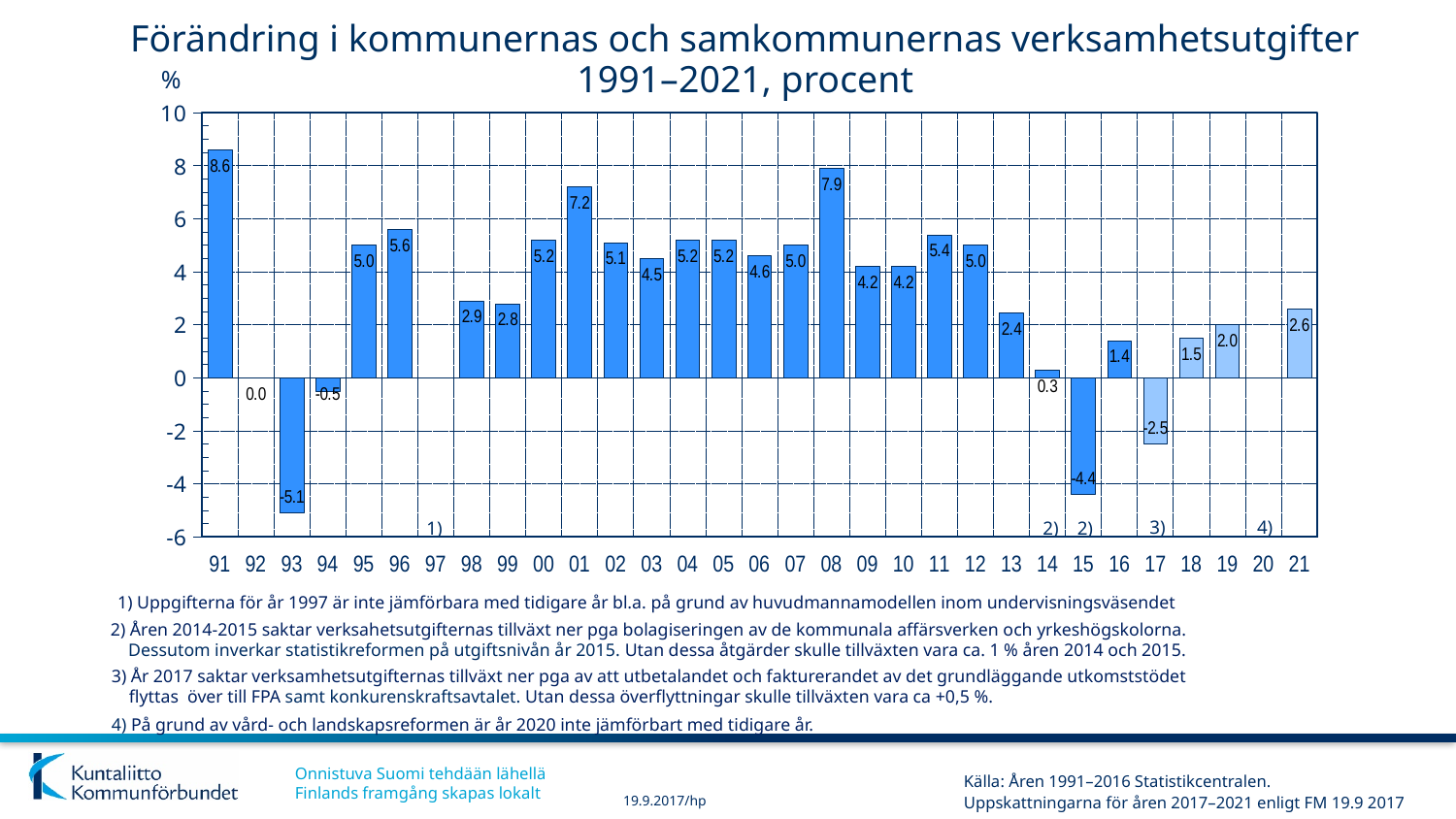
Which year has the lowest value? 1993 (93) Do the values rise or fall from 2018 to 2019? Rise What is the value for 1993? -5.1 Which is larger, the value for 2011 or the value for 2013? 2011 What is the value for 2021? 2.6 What is the value for 2008? 7.9 Is the value for 2017 greater or less than 0? less What kind of chart is shown on the slide? Bar chart What is the difference between the values for 2001 and 2002? 2.1 What is the value for 2015? -4.4 Which year has the highest value? 1991 (91) What unit is shown on the vertical axis? %